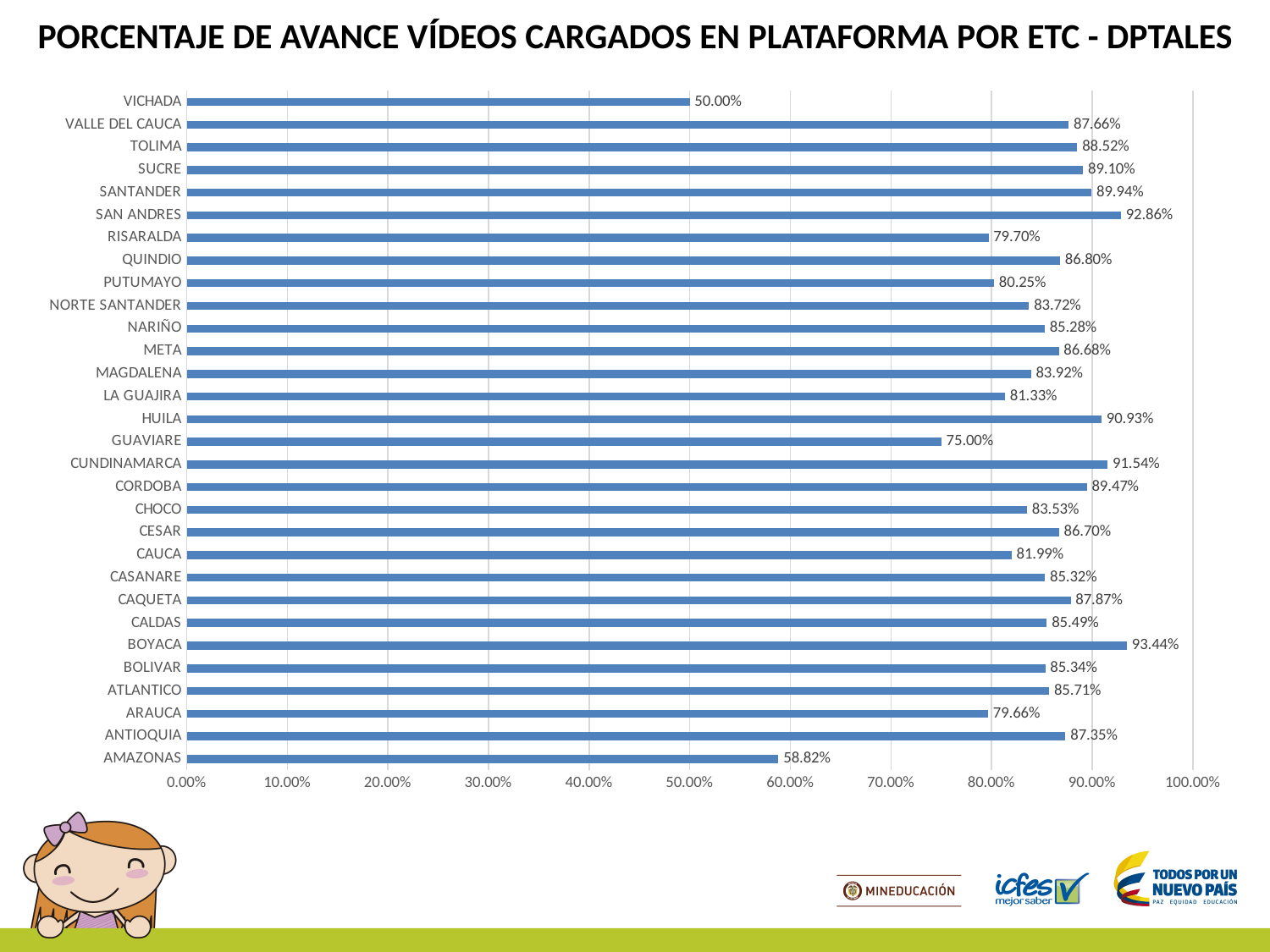
What is the value for CUNDINAMARCA? 91.54% What is the difference between the values for HUILA and GUAVIARE? 15.93% What is the value for AMAZONAS? 58.82% Which is larger, the value for SAN ANDRES or the value for RISARALDA? SAN ANDRES What kind of chart is shown on the slide? bar chart How many categories are shown in the chart? 30 What is the value for BOYACA? 93.44% What is the difference between the values for BOYACA and VICHADA? 43.44% Is the value for AMAZONAS greater or less than 60.00%? less Which category has the lowest value? VICHADA Which category has the highest value? BOYACA What is the value for GUAVIARE? 75.00%